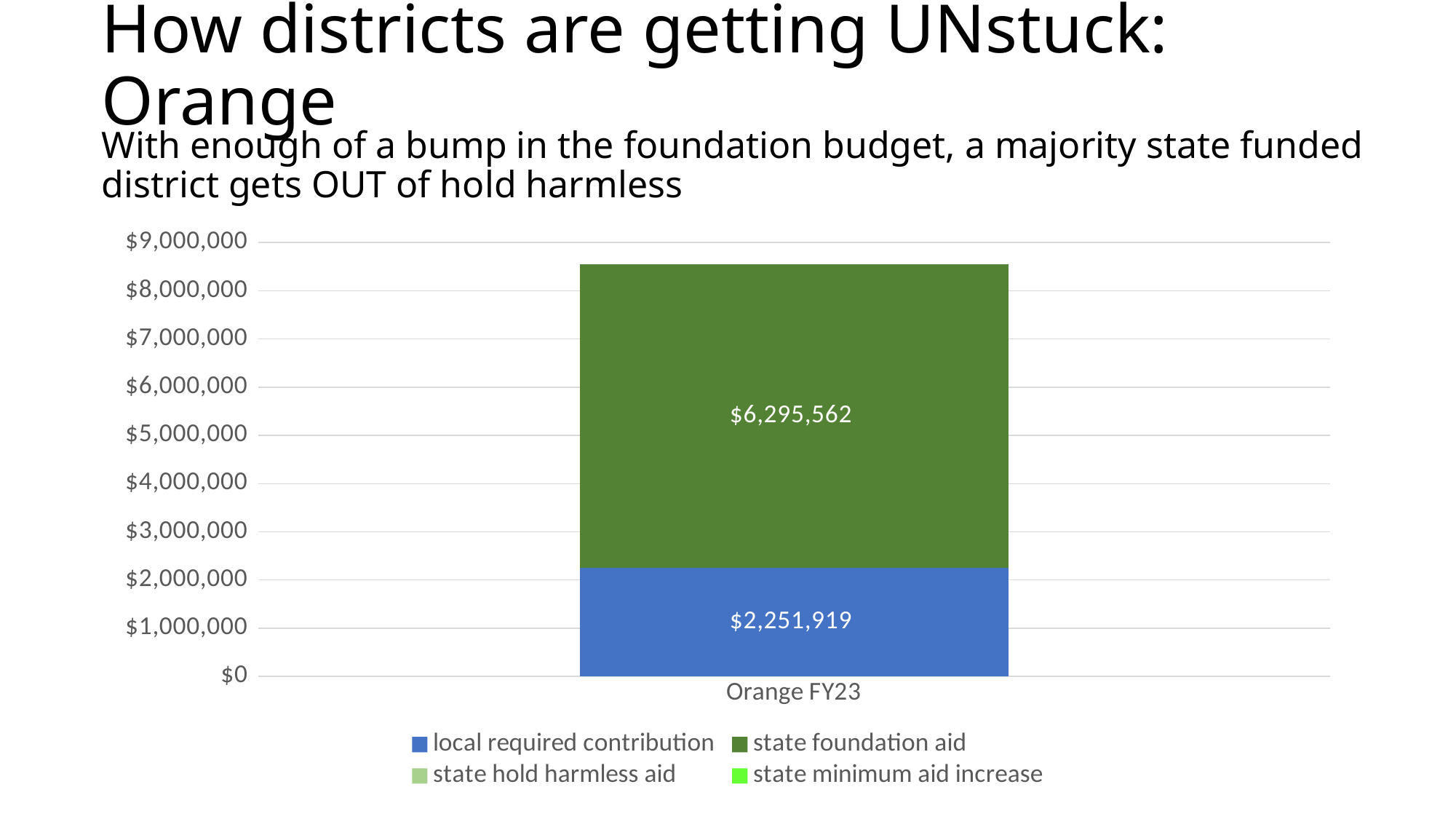
How many series does the legend list? 4 How many categories are shown on the x axis? 1 Is the top of the Orange FY23 stacked bar greater or less than $8,000,000? greater Is the local required contribution for Orange FY23 greater or less than $3,000,000? less What is the label of the category on the x axis? Orange FY23 What is the value of the local required contribution for Orange FY23? $2,251,919 Which is larger for Orange FY23, state foundation aid or local required contribution? state foundation aid What is the value of state foundation aid for Orange FY23? $6,295,562 What kind of chart is shown on the slide? stacked bar chart What is the total of the stacked bar for Orange FY23? $8,547,481 What is the difference between state foundation aid and local required contribution for Orange FY23? $4,043,643 Which legend entry is shown in blue? local required contribution